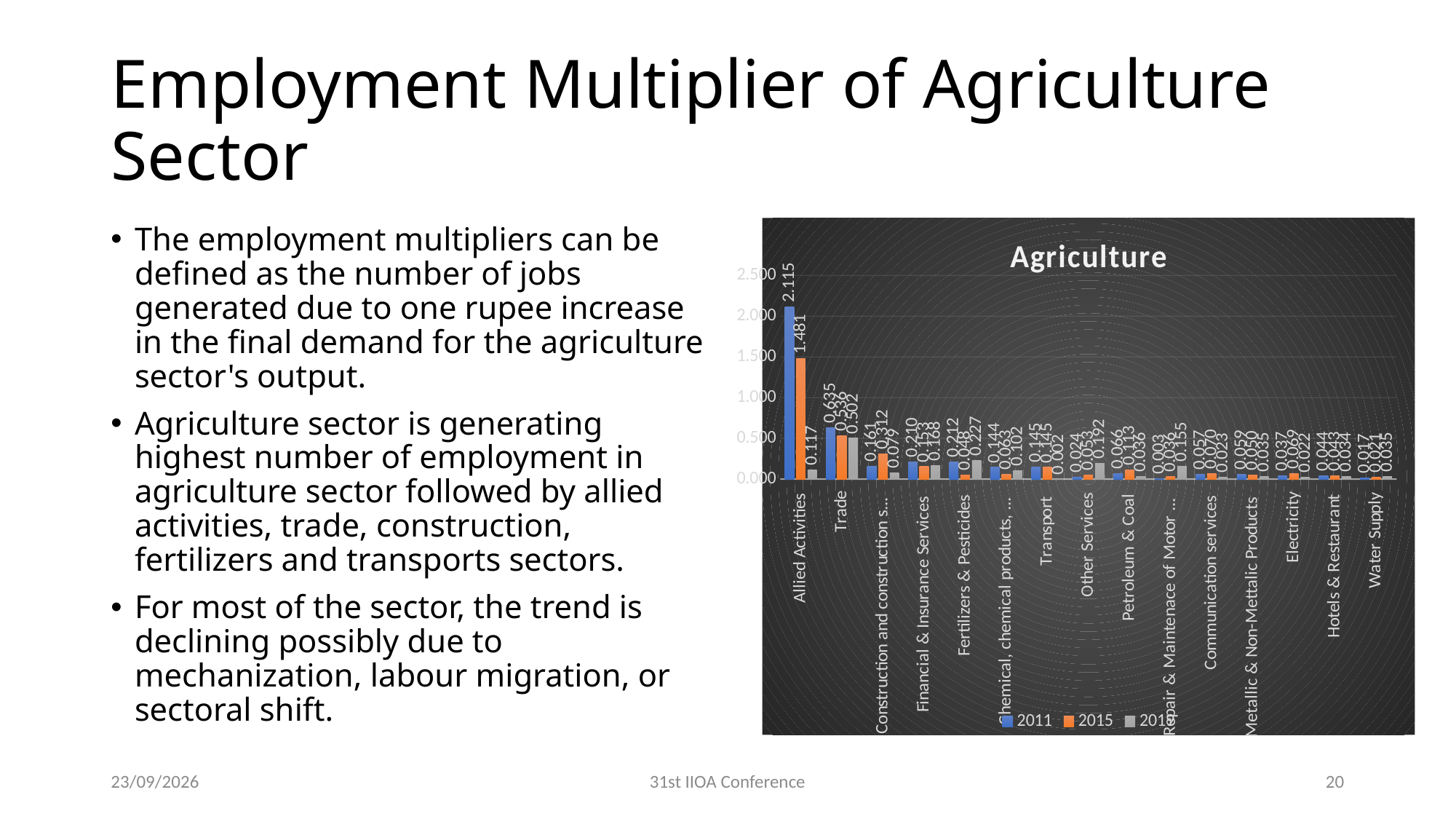
What is the 2011 value for Transport? 0.145 How many series does the legend list? 3 How many categories are shown on the x axis? 15 What is the 2015 value for Fertilizers & Pesticides? 0.048 What type of chart is shown on the slide? bar chart What is the difference between the 2011 and 2015 values for Allied Activities? 0.634 What is the title of the chart? Agriculture Which category has the highest 2011 value? Allied Activities What is the 2015 value for Trade? 0.536 What is the 2011 value for Allied Activities? 2.115 Is the 2011 value for Trade greater or less than 0.500? greater For Construction and construction s..., which is larger: the 2011 value or the 2015 value? 2015